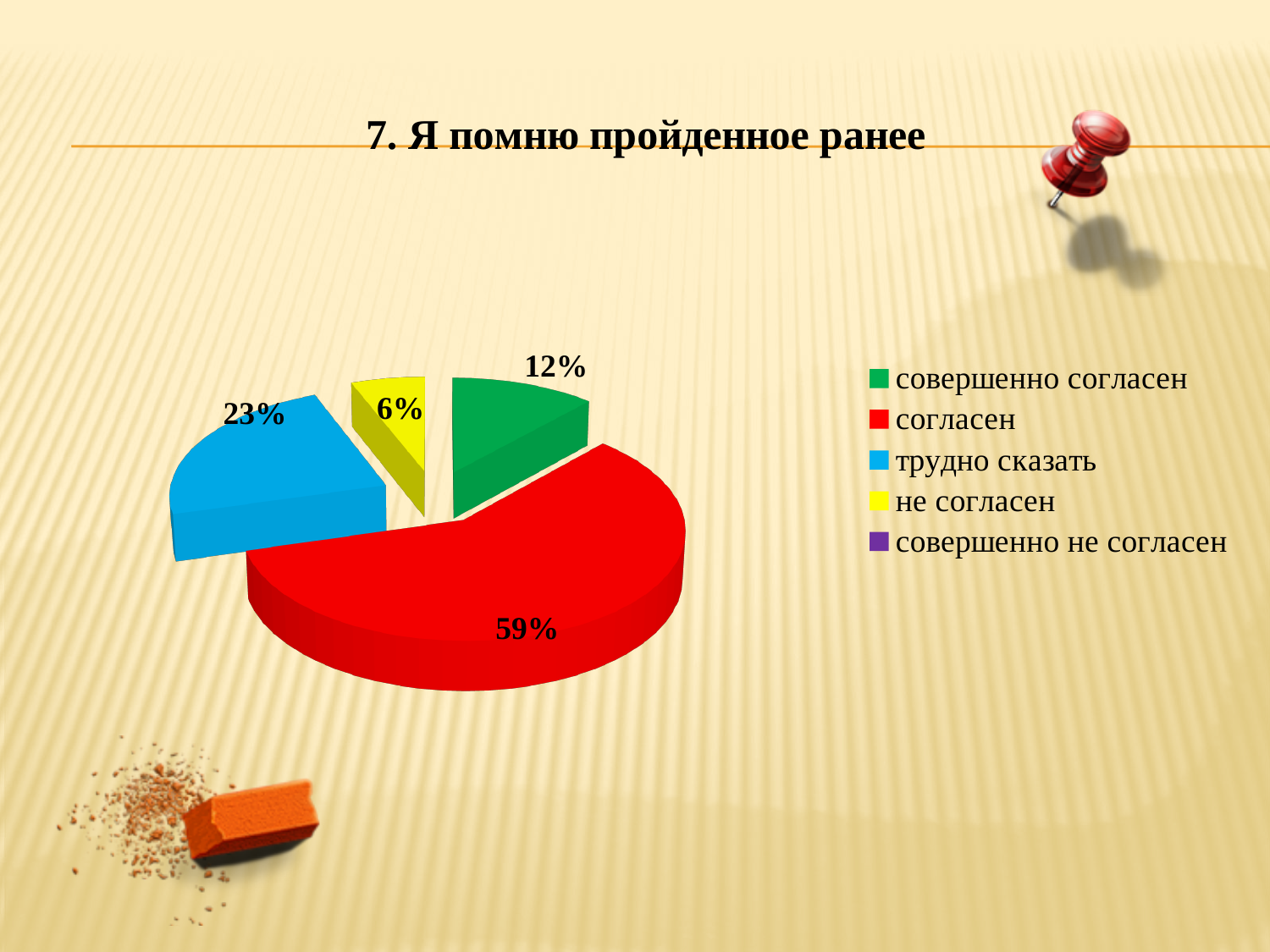
Which response has the largest share of the pie? согласен How many entries does the legend list? 5 What kind of chart is shown on the slide? pie chart What percentage of respondents answered "совершенно согласен"? 12% What percentage of respondents answered "не согласен"? 6% What is the title of the chart? 7. Я помню пройденное ранее What percentage of respondents answered "согласен"? 59% Which is larger, the share for "совершенно согласен" or the share for "не согласен"? совершенно согласен What colour is the slice for "трудно сказать"? blue What is the difference in percentage points between "согласен" and "трудно сказать"? 36 Which response with a visible slice has the smallest share of the pie? не согласен What percentage of respondents answered "трудно сказать"? 23%